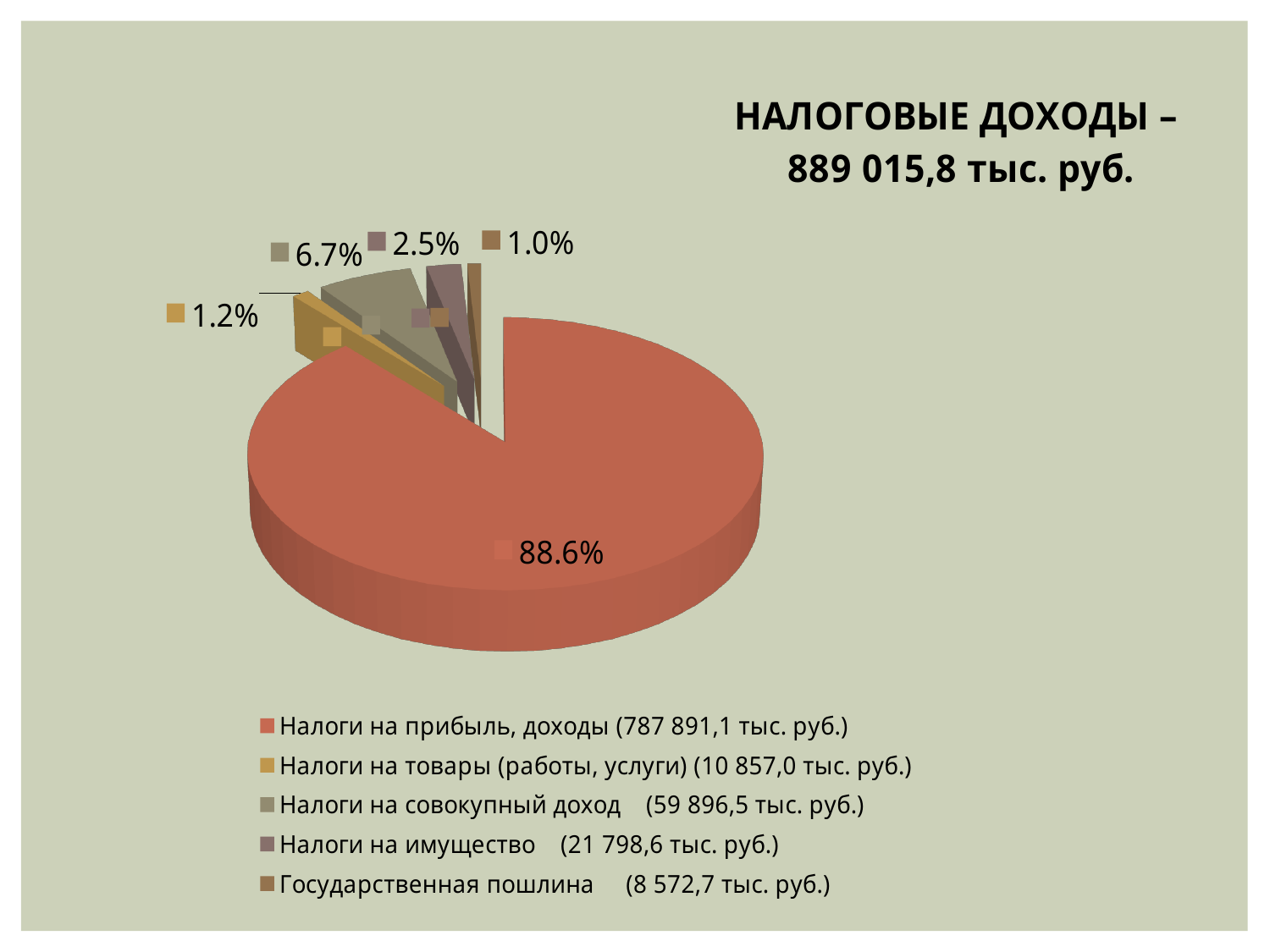
What share of the pie does "Государственная пошлина" take? 1.0% Which is larger: the share for "Налоги на имущество" or the share for "Налоги на совокупный доход"? Налоги на совокупный доход What total amount of tax revenue is stated in the chart title? 889 015,8 тыс. руб. How many slices does the pie chart have? 5 What share of the pie does "Налоги на прибыль, доходы" take? 88.6% Which category has the largest slice of the pie? Налоги на прибыль, доходы What kind of chart is shown on the slide? Pie chart What is the difference in percentage points between the shares of "Налоги на совокупный доход" and "Налоги на имущество"? 4.2 What share of the pie does "Налоги на имущество" take? 2.5% Which category has the smallest slice of the pie? Государственная пошлина